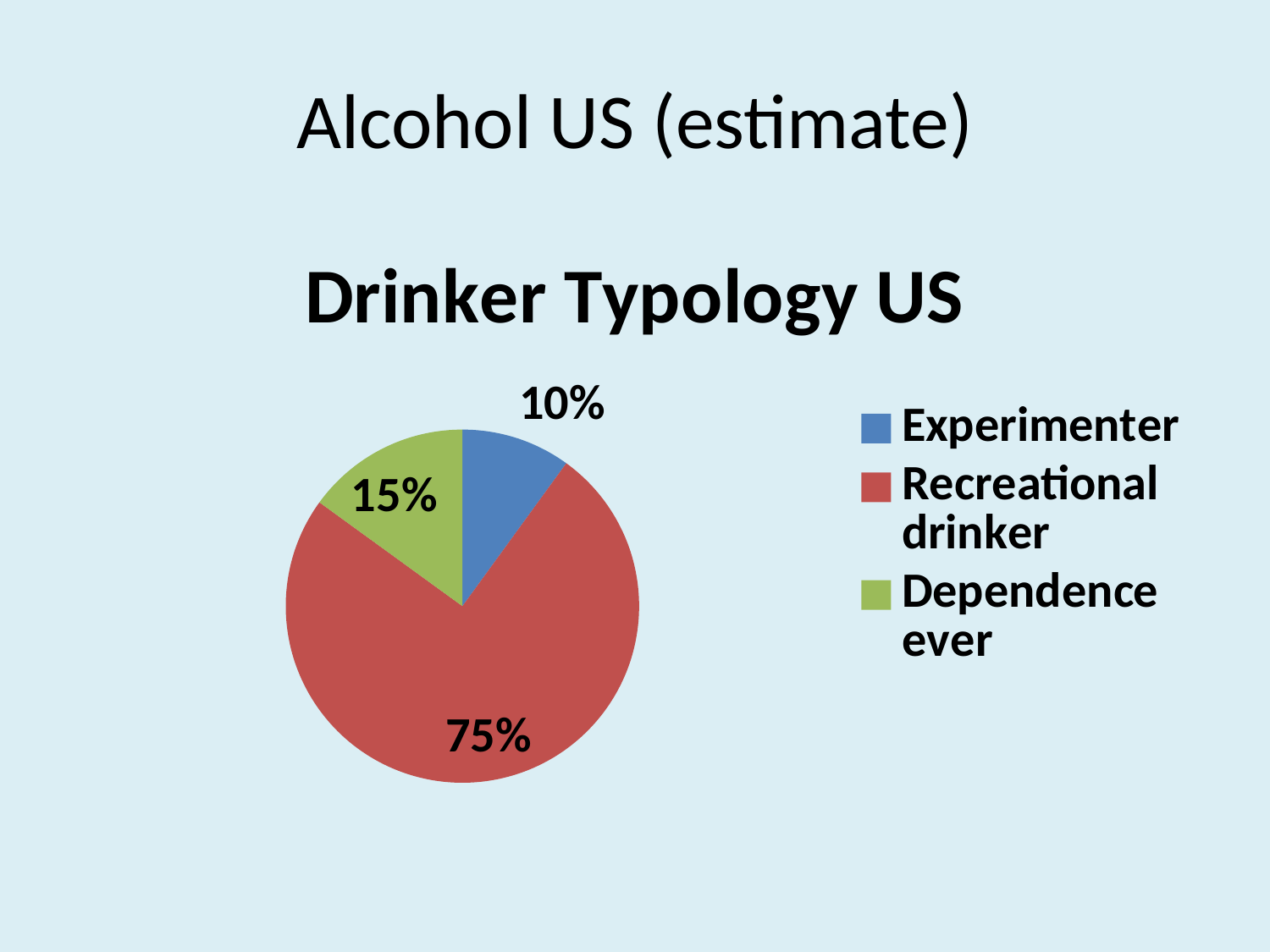
What share of the pie is Dependence ever? 15% What share of the pie is Experimenter? 10% What is the title of the chart? Drinker Typology US Which category has the smallest slice of the pie? Experimenter How many categories does the pie chart show? 3 What share of the pie is Recreational drinker? 75% Which is larger, Dependence ever or Experimenter? Dependence ever What is the difference in percentage points between Dependence ever and Experimenter? 5 Which colour represents Dependence ever in the legend? Green What is the difference in percentage points between Recreational drinker and Dependence ever? 60 What kind of chart is shown on the slide? Pie chart Which category has the largest slice of the pie? Recreational drinker